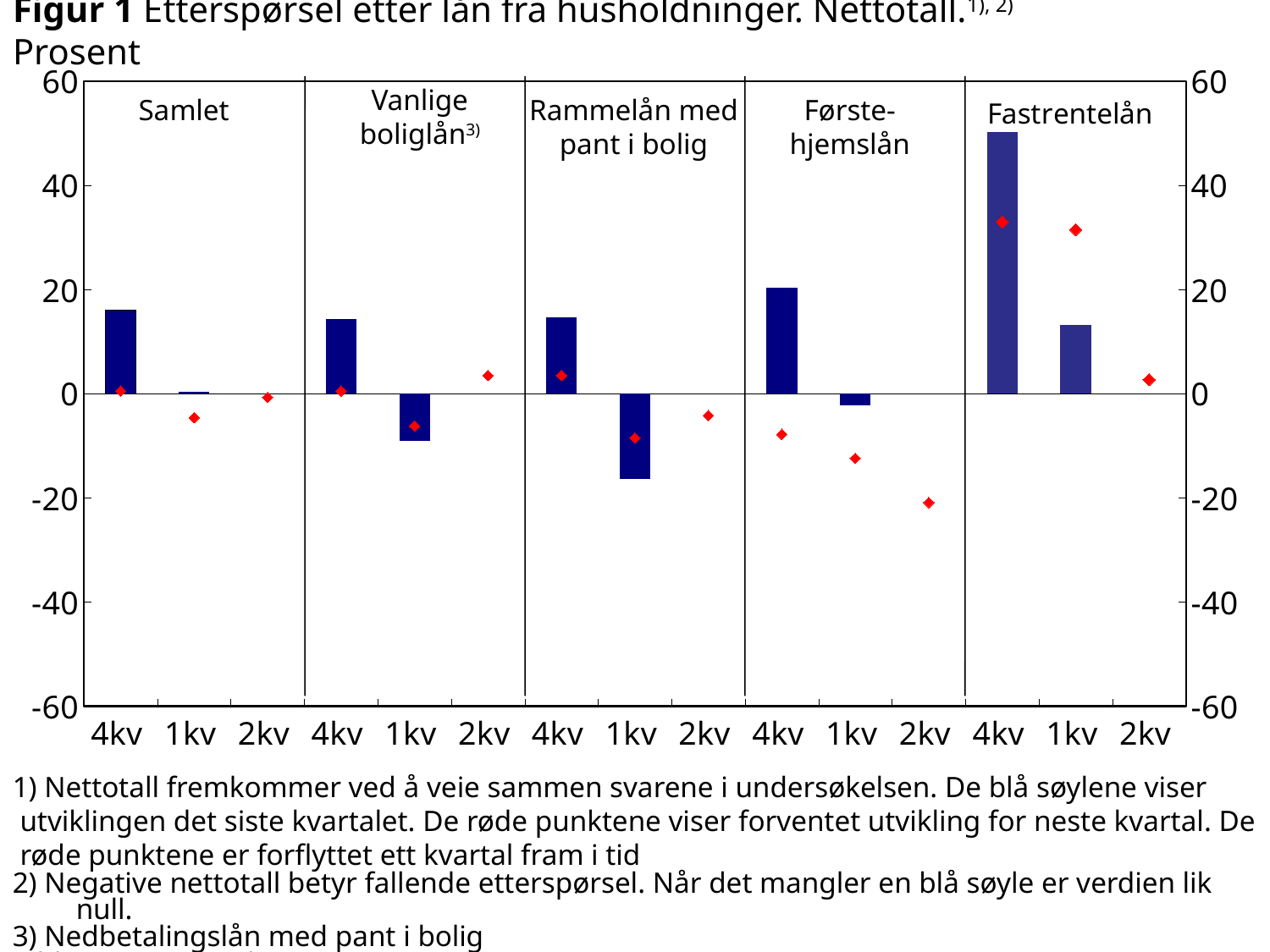
Is the 4kv blue bar for Samlet greater or less than 20? less According to the footnote, what do the red points show? Forventet utvikling for neste kvartal Is the 1kv blue bar for Vanlige boliglån greater or less than 0? less What is the title of the chart? Figur 1 Etterspørsel etter lån fra husholdninger. Nettotall. Prosent What kind of chart is shown on the slide? bar chart Which panel contains the tallest blue bar in the chart? Fastrentelån How many quarters are shown on the x axis within each panel? 3 Which panel contains the lowest (most negative) blue bar in the chart? Rammelån med pant i bolig Which is larger: the 4kv blue bar for Fastrentelån or the 4kv blue bar for Førstehjemslån? Fastrentelån How many loan categories (panels) are shown in the chart? 5 In the Førstehjemslån panel, do the red points rise or fall from 4kv to 2kv? fall Is the 4kv blue bar for Fastrentelån greater or less than 40? greater